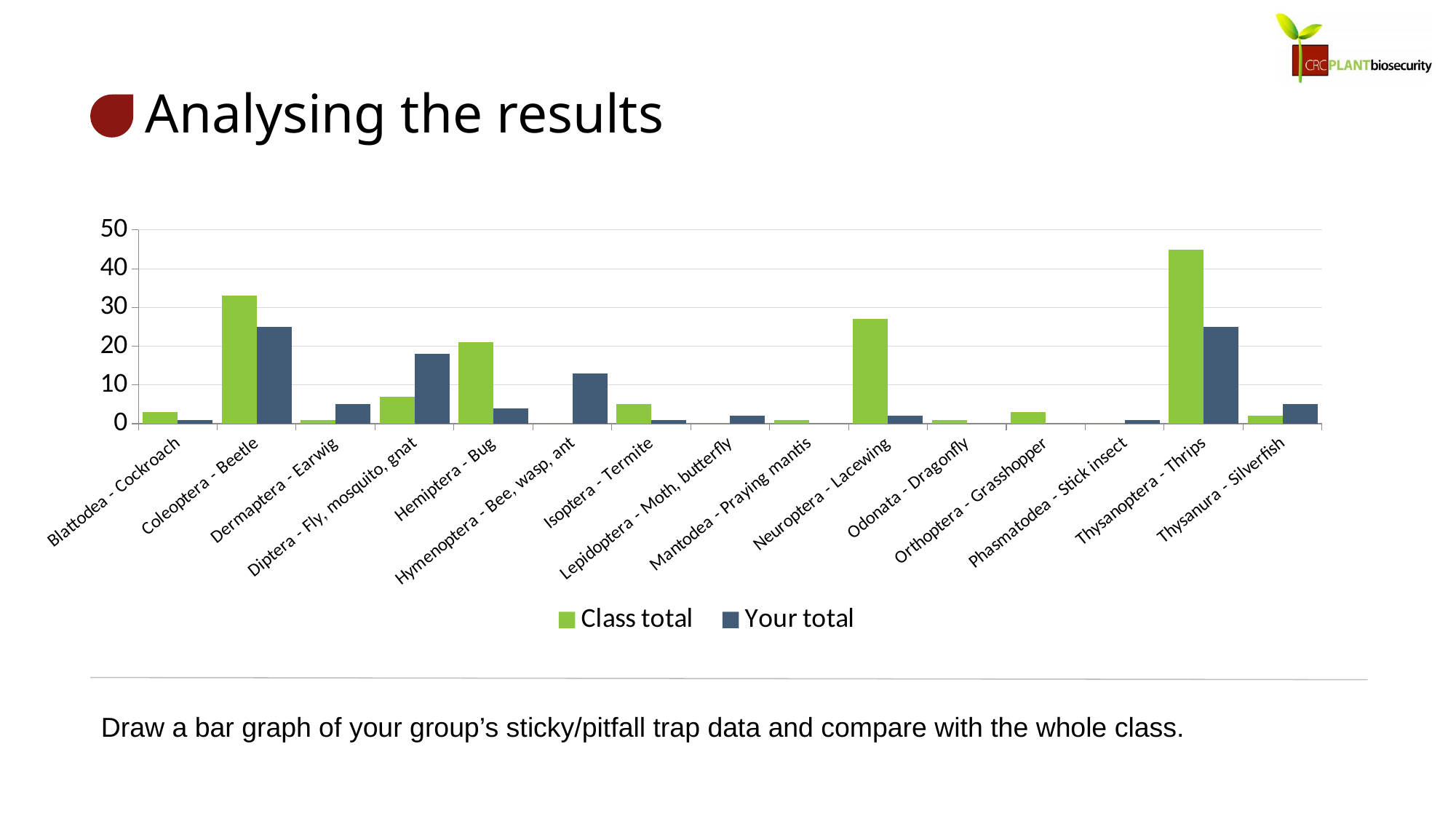
What kind of chart is shown on the slide? bar chart For Diptera - Fly, mosquito, gnat, which is larger: the Class total or the Your total? Your total Is the Your total for Hymenoptera - Bee, wasp, ant greater or less than 20? less How many insect order categories are shown on the x axis? 15 How many series does the legend list? 2 Is the Class total for Thysanoptera - Thrips greater or less than 40? greater Is the Class total for Neuroptera - Lacewing greater or less than 20? greater Which category has the highest Class total? Thysanoptera - Thrips For Coleoptera - Beetle, which is larger: the Class total or the Your total? Class total What are the two series named in the legend? Class total and Your total Which colour represents the Class total series? green